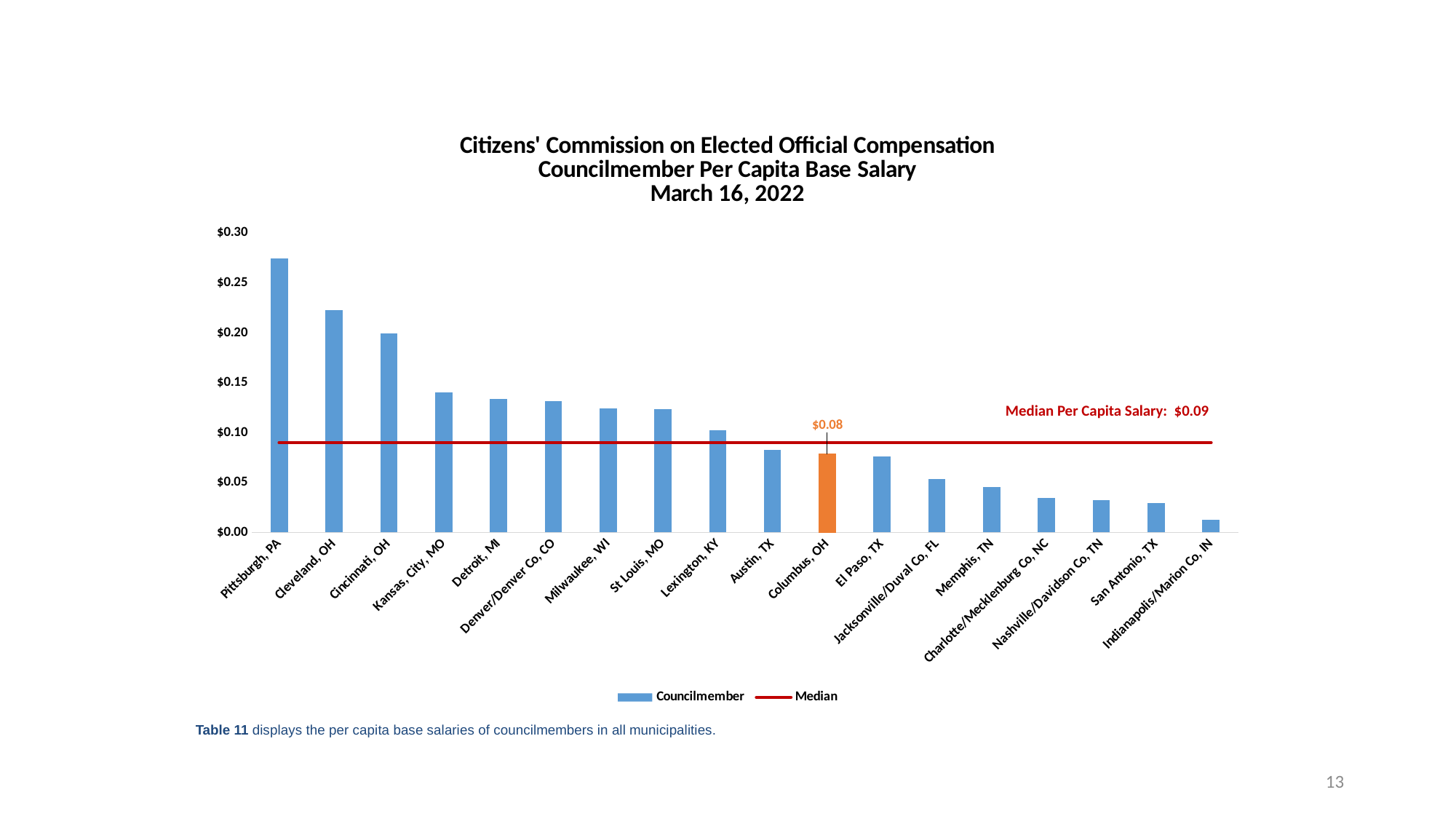
How many entries does the legend list? 2 What is the councilmember per capita base salary for Columbus, OH? $0.08 Which municipality has the highest councilmember per capita base salary? Pittsburgh, PA How many municipalities are plotted on the chart? 18 Which municipality has the lowest councilmember per capita base salary? Indianapolis/Marion Co, IN Is the value for Kansas City, MO greater or less than $0.15? less Is the value for Pittsburgh, PA greater or less than $0.25? greater What is the median per capita salary shown on the chart? $0.09 Do the bar values rise or fall moving from left to right along the x axis? fall Which has a higher councilmember per capita base salary, Cleveland, OH or Cincinnati, OH? Cleveland, OH What kind of chart is shown on the slide? bar chart Is the value for Charlotte/Mecklenburg Co, NC greater or less than $0.05? less